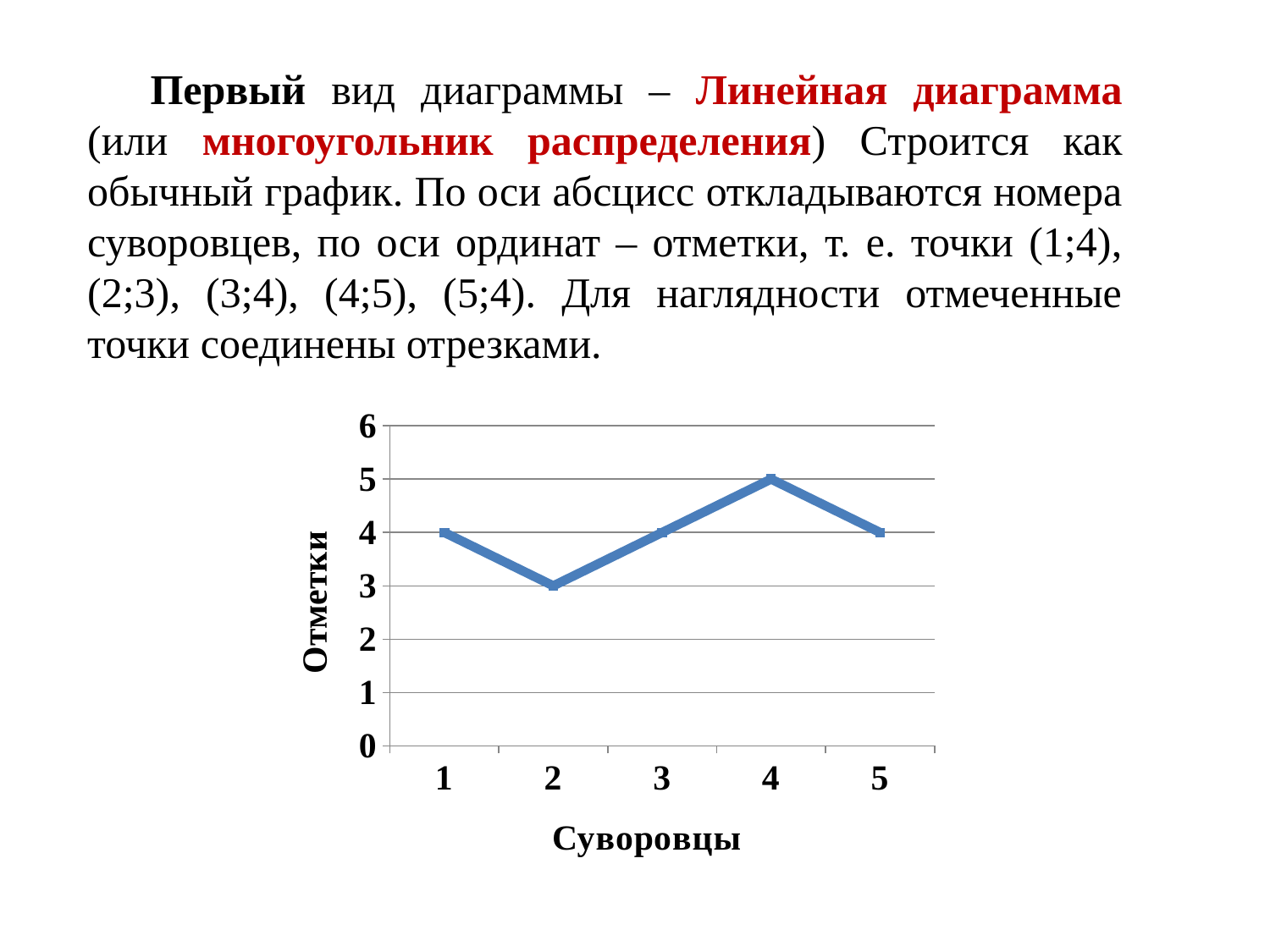
How many Suvorovtsy (points) are plotted on the chart? 5 What is the difference between the marks of Suvorovets 4 and Suvorovets 2? 2 What is the mark (Отметки) for Suvorovets 1? 4 What is the mark (Отметки) for Suvorovets 2? 3 What is the mark (Отметки) for Suvorovets 5? 4 What is the label of the vertical axis of the chart? Отметки Which Suvorovets has the lowest mark? 2 Which has a higher mark, Suvorovets 3 or Suvorovets 4? Suvorovets 4 What type of chart is shown on the slide? line chart Which Suvorovets has the highest mark? 4 Do the marks rise or fall from Suvorovets 2 to Suvorovets 4? rise What is the mark (Отметки) for Suvorovets 4? 5